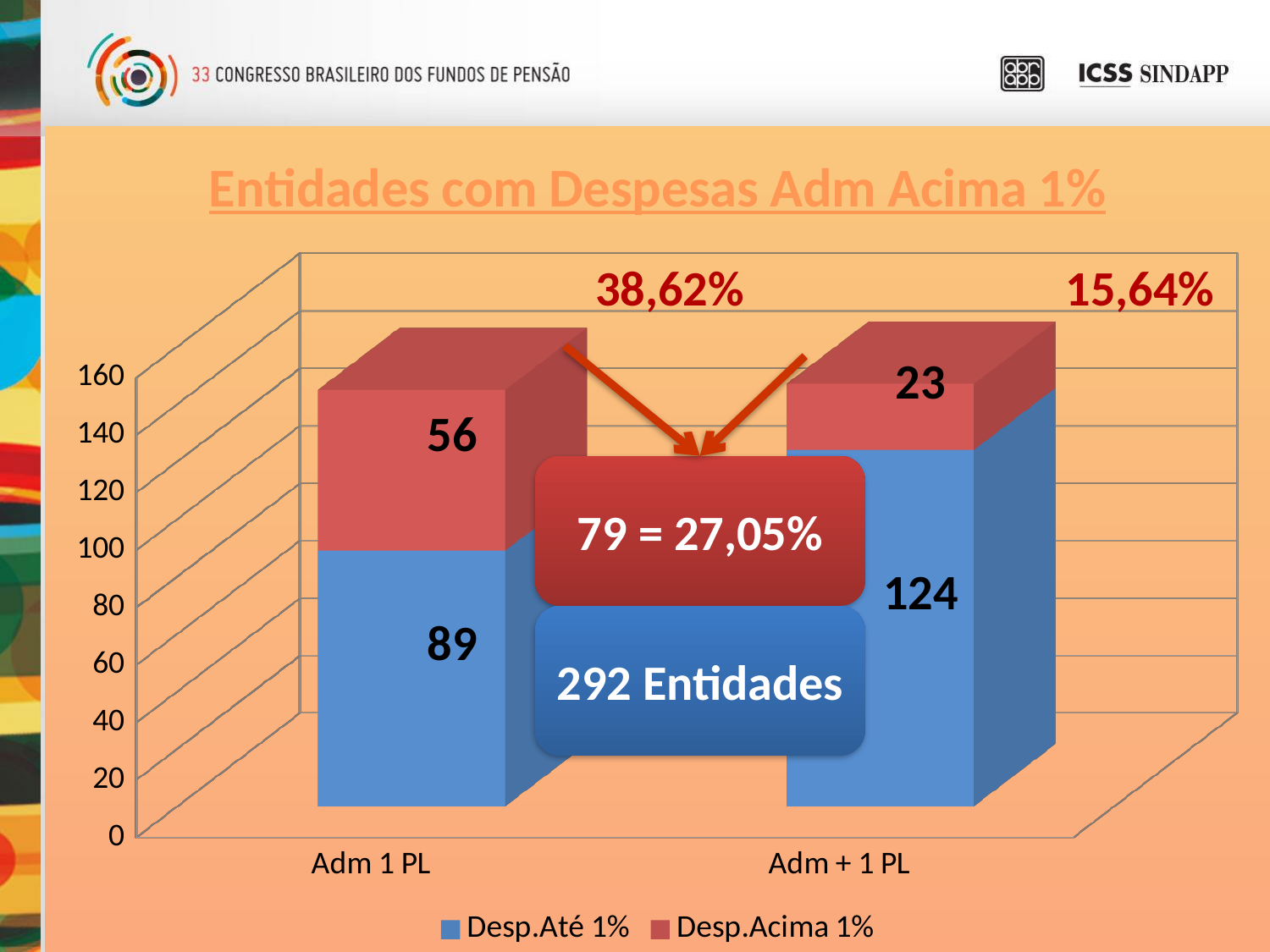
What is the total of the stacked bar for Adm 1 PL? 145 How many series does the legend list? 2 How many categories are shown on the x axis? 2 Is the Desp.Acima 1% value larger for Adm 1 PL or for Adm + 1 PL? Adm 1 PL What is the value of Desp.Acima 1% for Adm + 1 PL? 23 Which category has the lower Desp.Até 1% value? Adm 1 PL What is the value of Desp.Até 1% for Adm + 1 PL? 124 What is the value of Desp.Até 1% for Adm 1 PL? 89 What is the value of Desp.Acima 1% for Adm 1 PL? 56 Which category has the higher Desp.Acima 1% value? Adm 1 PL What is the difference between the Desp.Até 1% values for Adm + 1 PL and Adm 1 PL? 35 What type of chart is shown on the slide? Stacked bar chart